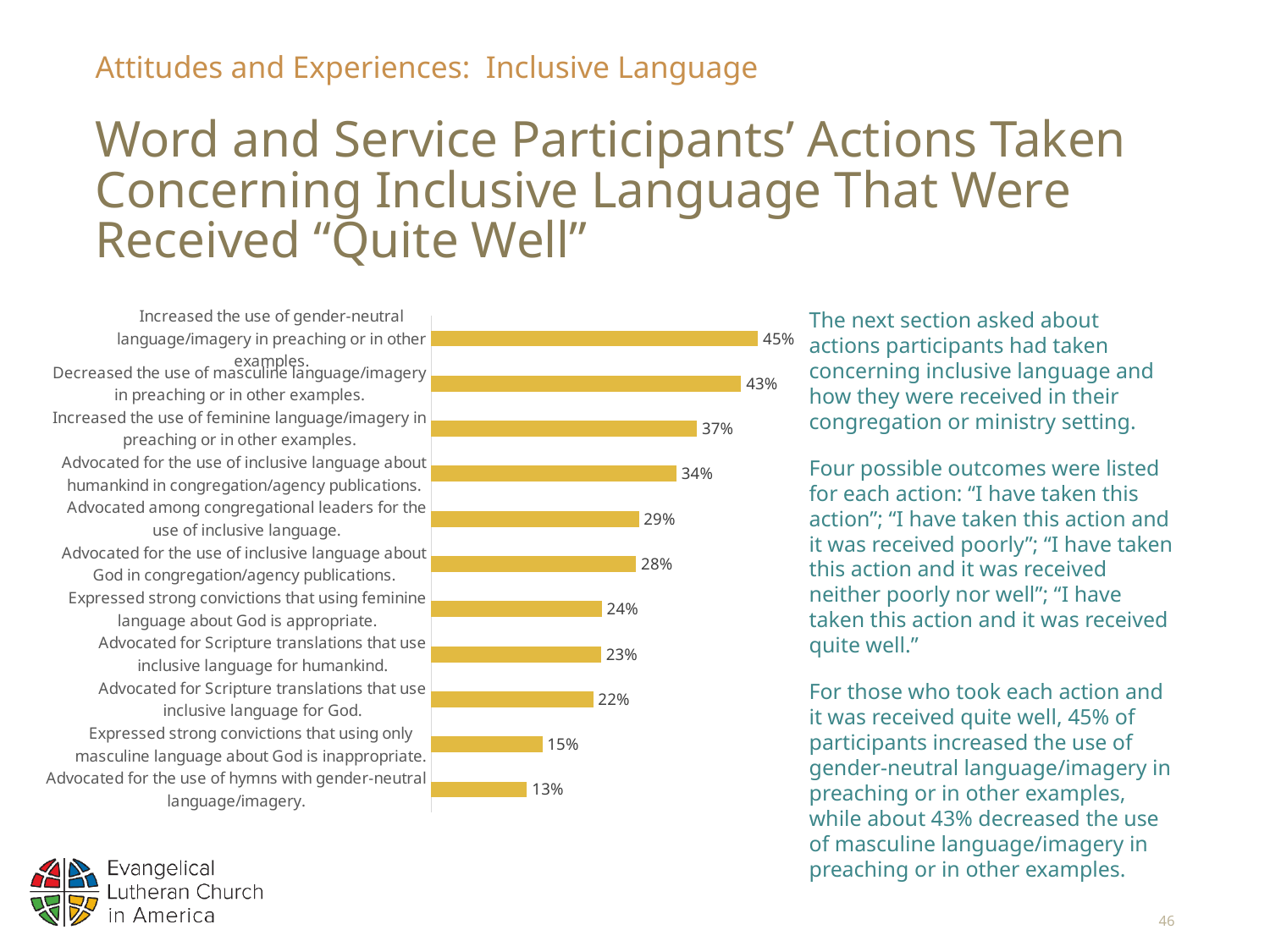
What kind of chart is shown on the slide? Bar chart Which action has the lowest percentage in the chart? Advocated for the use of hymns with gender-neutral language/imagery. Which is larger: the value for 'Expressed strong convictions that using feminine language about God is appropriate' or 'Expressed strong convictions that using only masculine language about God is inappropriate'? Expressed strong convictions that using feminine language about God is appropriate. What is the difference between the value for 'Increased the use of feminine language/imagery in preaching or in other examples' and 'Advocated for the use of hymns with gender-neutral language/imagery'? 24% What colour are the bars in the chart? Gold/yellow Which action has the highest percentage in the chart? Increased the use of gender-neutral language/imagery in preaching or in other examples. What percentage of participants increased the use of gender-neutral language/imagery in preaching or in other examples and had it received quite well? 45% What is the value for 'Advocated for the use of hymns with gender-neutral language/imagery'? 13% How many actions (categories) are shown in the chart? 11 What is the value for 'Advocated among congregational leaders for the use of inclusive language'? 29% What is the difference between the value for 'Increased the use of gender-neutral language/imagery in preaching or in other examples' and 'Decreased the use of masculine language/imagery in preaching or in other examples'? 2% What is the value for 'Advocated for Scripture translations that use inclusive language for God'? 22%